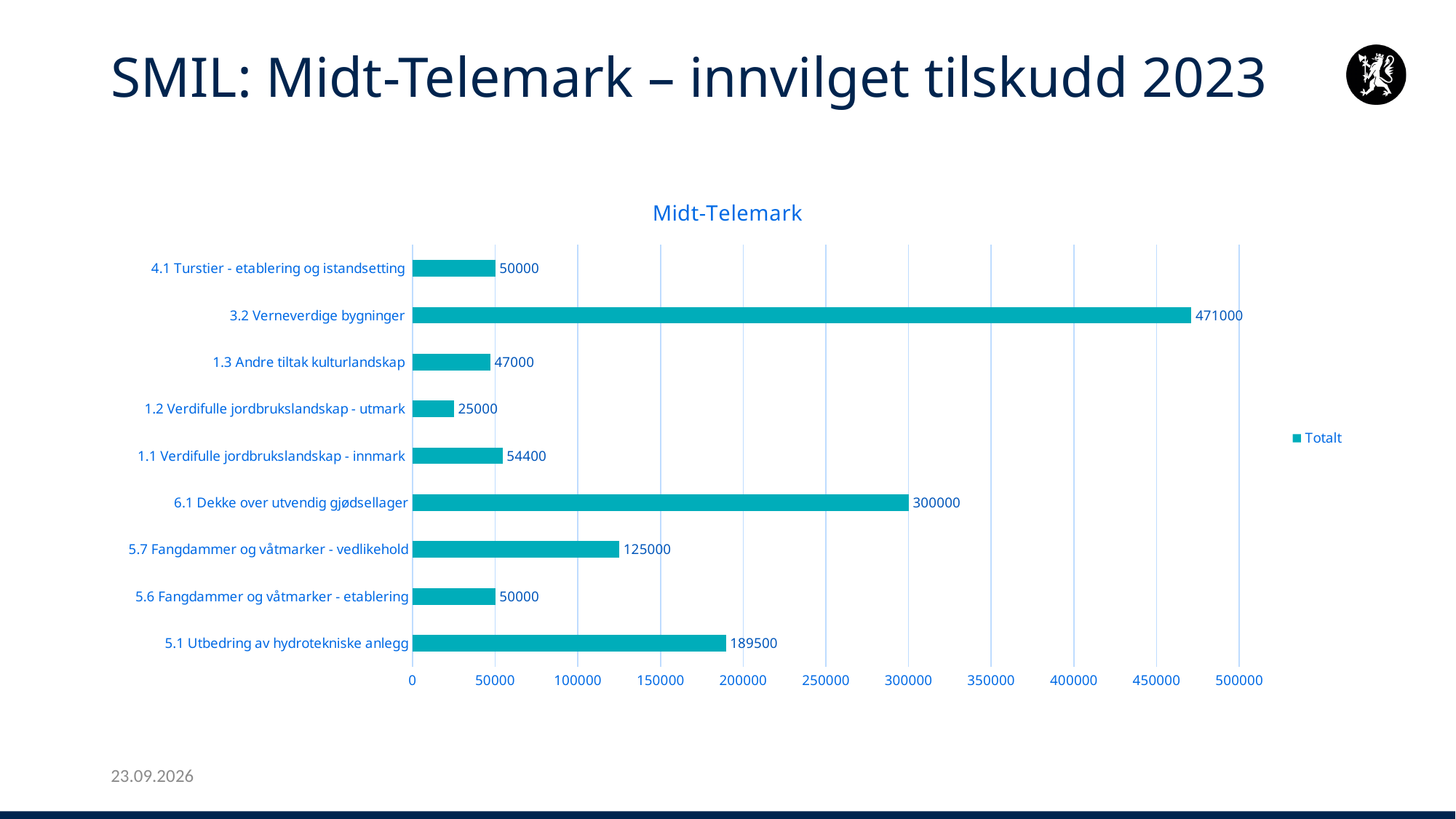
What is the title of the chart? Midt-Telemark What is the value for 5.1 Utbedring av hydrotekniske anlegg? 189500 How many categories are shown in the chart? 9 Which category has the lowest value? 1.2 Verdifulle jordbrukslandskap - utmark What is the difference between the values for 6.1 Dekke over utvendig gjødsellager and 5.7 Fangdammer og våtmarker - vedlikehold? 175000 What is the value for 3.2 Verneverdige bygninger? 471000 How many series does the legend list? 1 Is the value for 5.1 Utbedring av hydrotekniske anlegg greater or less than 200000? less Which category has the highest value? 3.2 Verneverdige bygninger What is the value for 1.1 Verdifulle jordbrukslandskap - innmark? 54400 Which is larger: the value for 1.3 Andre tiltak kulturlandskap or the value for 1.1 Verdifulle jordbrukslandskap - innmark? 1.1 Verdifulle jordbrukslandskap - innmark What kind of chart is shown on the slide? bar chart